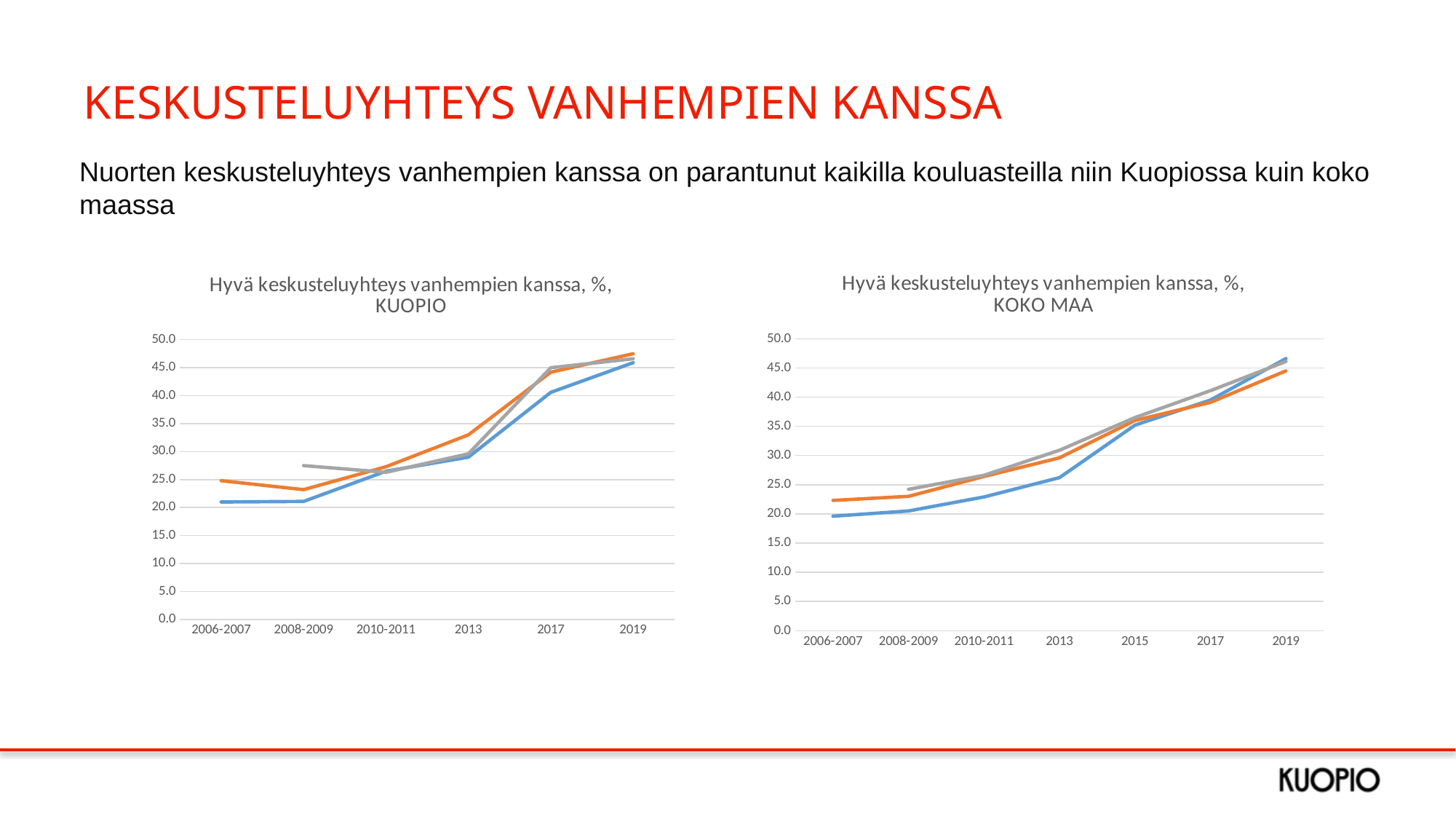
In the KOKO MAA chart, are the values for 2006-2007 greater or less than 25.0? less What kind of chart is the chart titled "Hyvä keskusteluyhteys vanhempien kanssa, %, KUOPIO"? line chart In the KUOPIO chart, do the values generally rise or fall from 2006-2007 to 2019? rise In the KUOPIO chart, are the values for 2019 greater or less than 40.0? greater How many time periods are shown on the x axis of the KUOPIO chart? 6 In the KOKO MAA chart, do the values generally rise or fall from 2006-2007 to 2019? rise In the KOKO MAA chart, are the values for 2017 greater or less than 35.0? greater How many time periods are shown on the x axis of the KOKO MAA chart? 7 What is the title of the chart on the right side of the slide? Hyvä keskusteluyhteys vanhempien kanssa, %, KOKO MAA In the KOKO MAA chart, which time period has the highest values? 2019 How many charts are shown on the slide? 2